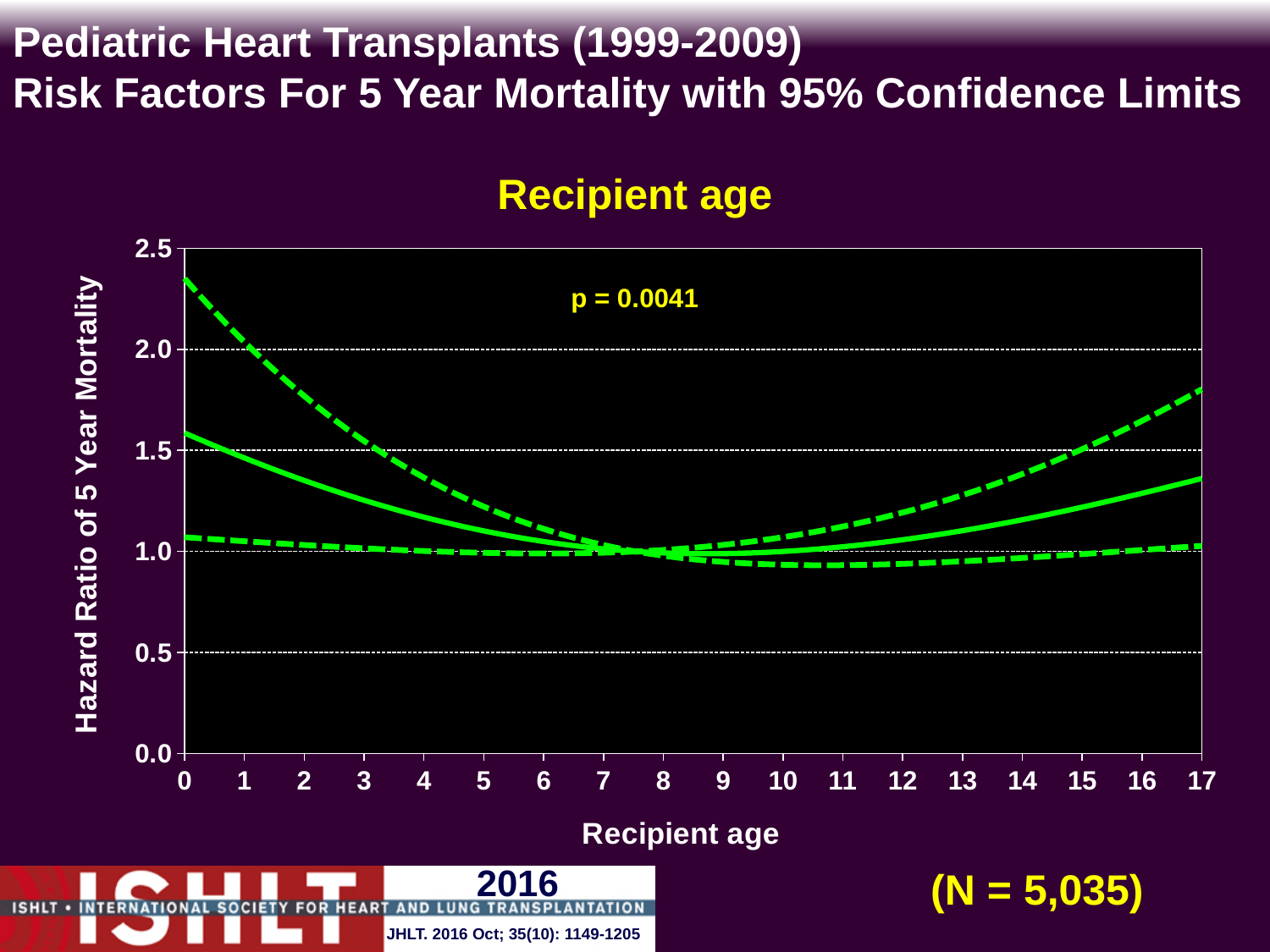
What is the label of the y axis? Hazard Ratio of 5 Year Mortality Does the solid hazard ratio line rise or fall between recipient age 0 and recipient age 7? fall What p-value is printed on the chart? p = 0.0041 How many lines are plotted on the chart? 3 Is the upper dashed confidence limit at recipient age 17 greater or less than 1.5? greater Is the solid hazard ratio line at recipient age 3 greater or less than 1.0? greater Is the upper dashed confidence limit at recipient age 0 greater or less than 2.0? greater What kind of chart is shown on the slide? line chart Does the solid hazard ratio line rise or fall between recipient age 10 and recipient age 17? rise What sample size (N) is printed on the slide? N = 5,035 What is the title of the chart? Recipient age